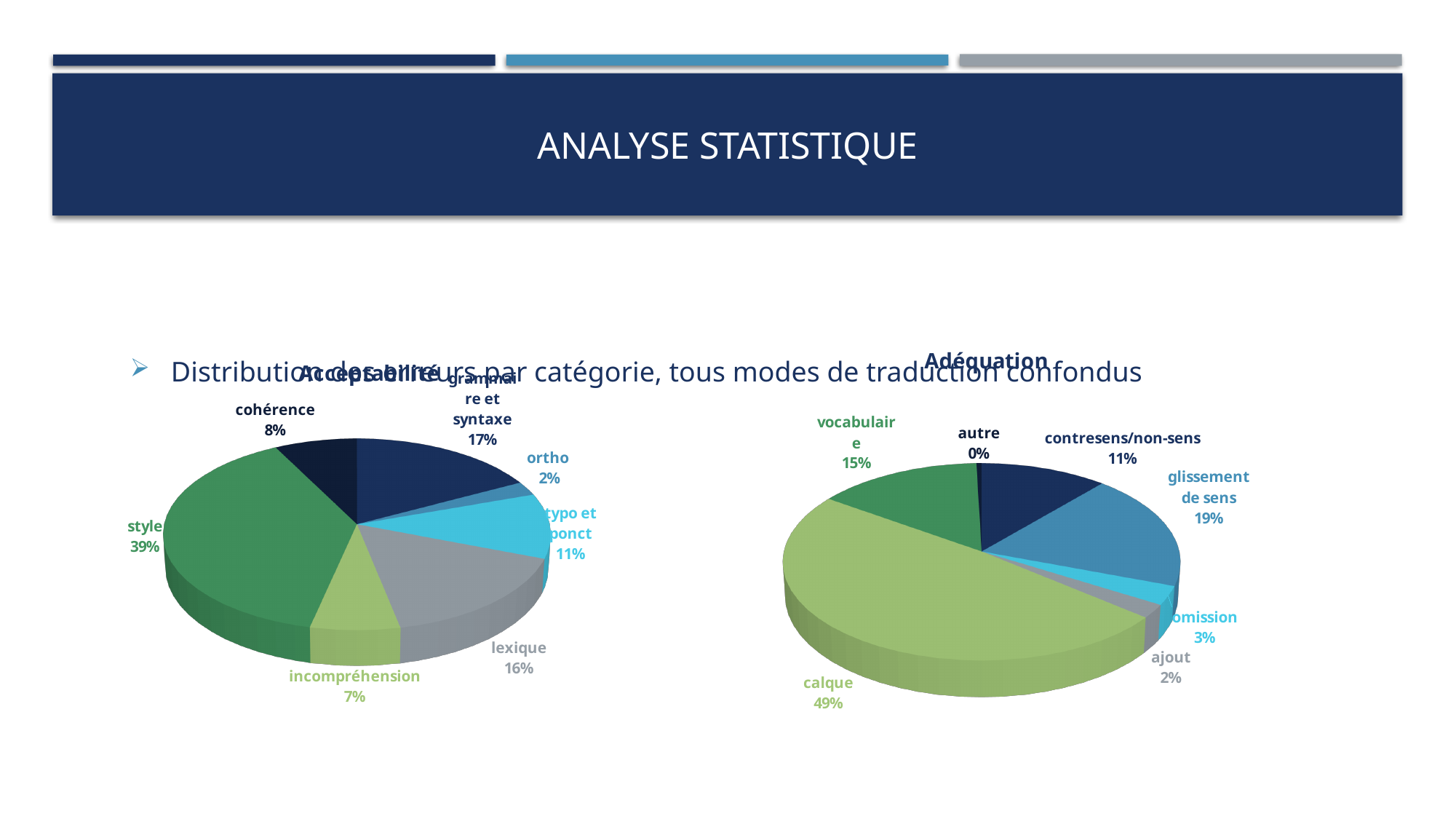
In the Adéquation chart, what is the difference between the shares for omission and ajout? 1% In the left pie chart, what is the difference between the shares for grammaire et syntaxe and cohérence? 9% In the left pie chart, what share is labelled for lexique? 16% In the left pie chart, which category has the smallest slice? ortho In the Adéquation chart, what share is labelled for calque? 49% What kind of chart is the Adéquation chart? pie chart In the Adéquation chart, which category has the largest slice? calque In the left pie chart, what share is labelled for style? 39% In the left pie chart, which category has the largest slice? style In the Adéquation chart, what share is labelled for glissement de sens? 19% In the Adéquation chart, which is larger, vocabulaire or contresens/non-sens? vocabulaire In the left pie chart, how many categories are shown? 7